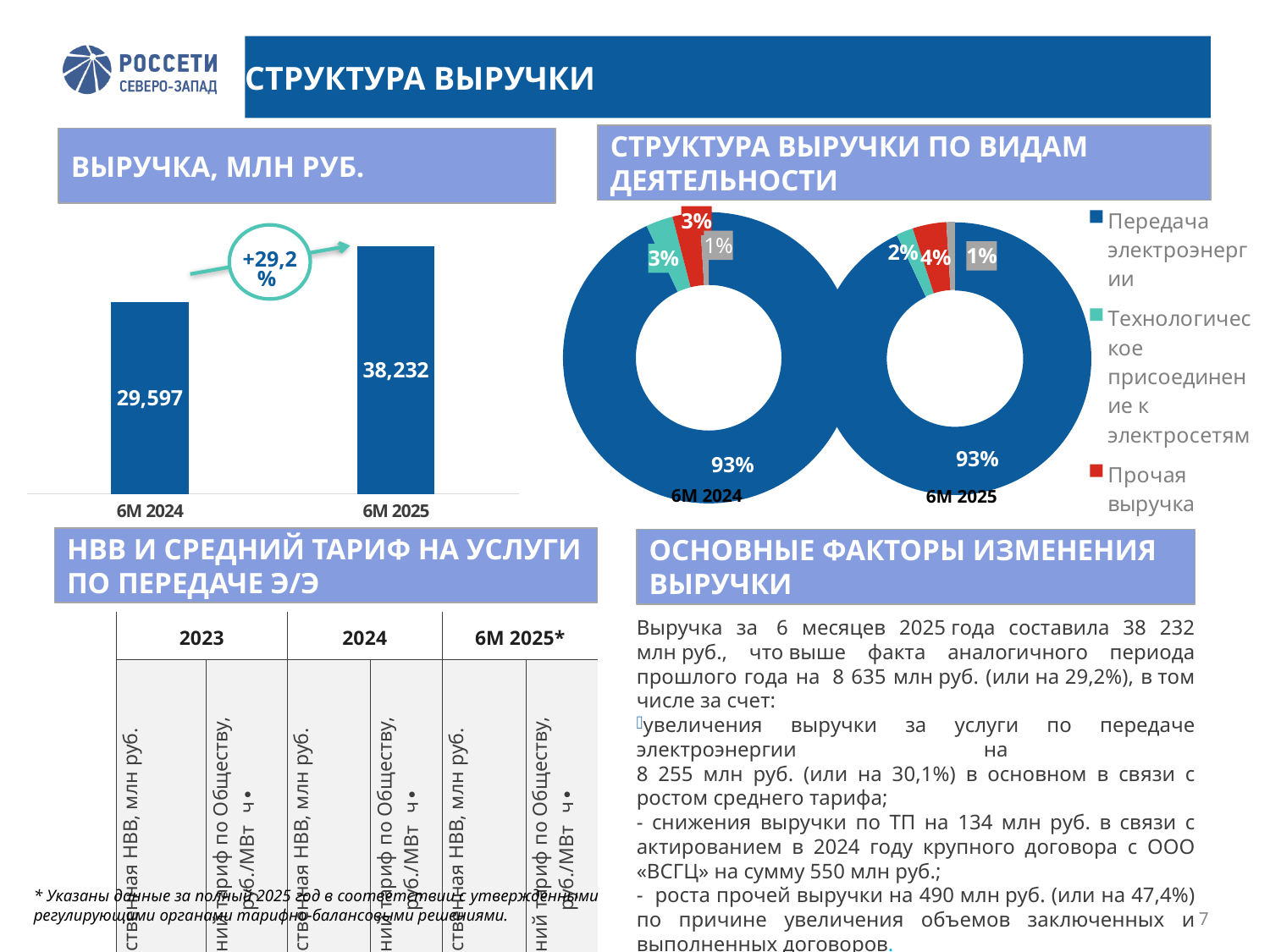
In the chart 'ВЫРУЧКА, МЛН РУБ.', what is the value for 6М 2025? 38,232 In the chart 'ВЫРУЧКА, МЛН РУБ.', which period has the higher value? 6М 2025 What type of chart is 'СТРУКТУРА ВЫРУЧКИ ПО ВИДАМ ДЕЯТЕЛЬНОСТИ'? Donut (pie) chart In the chart 'СТРУКТУРА ВЫРУЧКИ ПО ВИДАМ ДЕЯТЕЛЬНОСТИ', what share does 'Технологическое присоединение к электросетям' have in 6М 2024? 3% In the chart 'СТРУКТУРА ВЫРУЧКИ ПО ВИДАМ ДЕЯТЕЛЬНОСТИ', which category has the largest share in 6М 2024? Передача электроэнергии In the chart 'СТРУКТУРА ВЫРУЧКИ ПО ВИДАМ ДЕЯТЕЛЬНОСТИ', what share does 'Прочая выручка' have in 6М 2025? 4% In the chart 'ВЫРУЧКА, МЛН РУБ.', what is the value for 6М 2024? 29,597 How many bars are in the chart 'ВЫРУЧКА, МЛН РУБ.'? 2 In the chart 'ВЫРУЧКА, МЛН РУБ.', what is the difference between the 6М 2025 and 6М 2024 values? 8,635 In the chart 'СТРУКТУРА ВЫРУЧКИ ПО ВИДАМ ДЕЯТЕЛЬНОСТИ', what share does 'Передача электроэнергии' have in 6М 2025? 93% What type of chart is 'ВЫРУЧКА, МЛН РУБ.'? Bar chart In the chart 'ВЫРУЧКА, МЛН РУБ.', what percentage change is shown between 6М 2024 and 6М 2025? +29,2%